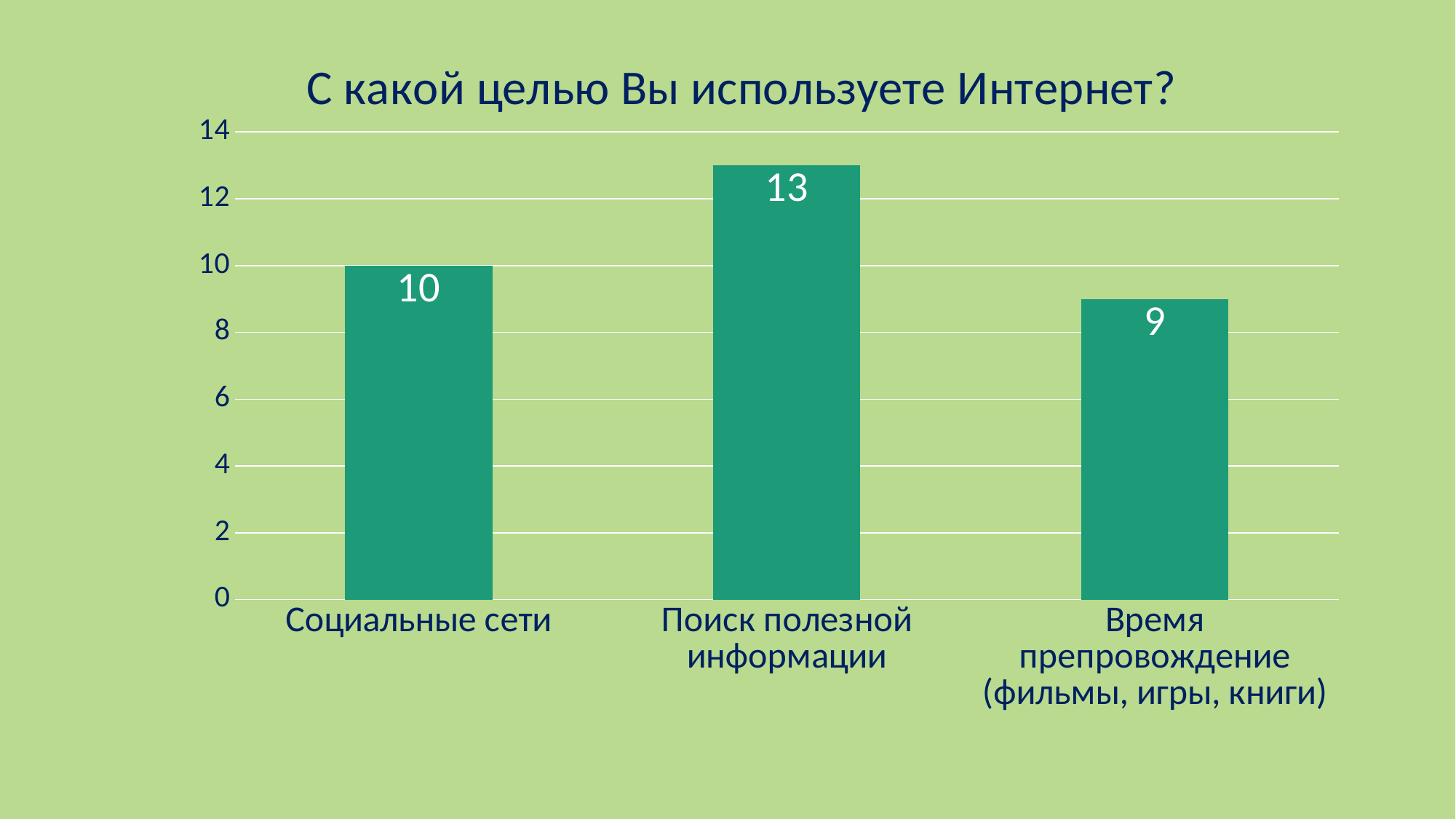
What kind of chart is shown on the slide? bar chart What is the difference between the values for Социальные сети and Времяпрепровождение (фильмы, игры, книги)? 1 What is the value for Времяпрепровождение (фильмы, игры, книги)? 9 How many categories are shown in the chart? 3 Which category has the lowest value? Времяпрепровождение (фильмы, игры, книги) Which is larger: the value for Социальные сети or the value for Времяпрепровождение (фильмы, игры, книги)? Социальные сети What is the difference between the values for Поиск полезной информации and Социальные сети? 3 What is the title of the chart? С какой целью Вы используете Интернет? Which category has the highest value? Поиск полезной информации Is the value for Поиск полезной информации greater or less than 12? greater What is the value for Поиск полезной информации? 13 What is the value for Социальные сети? 10